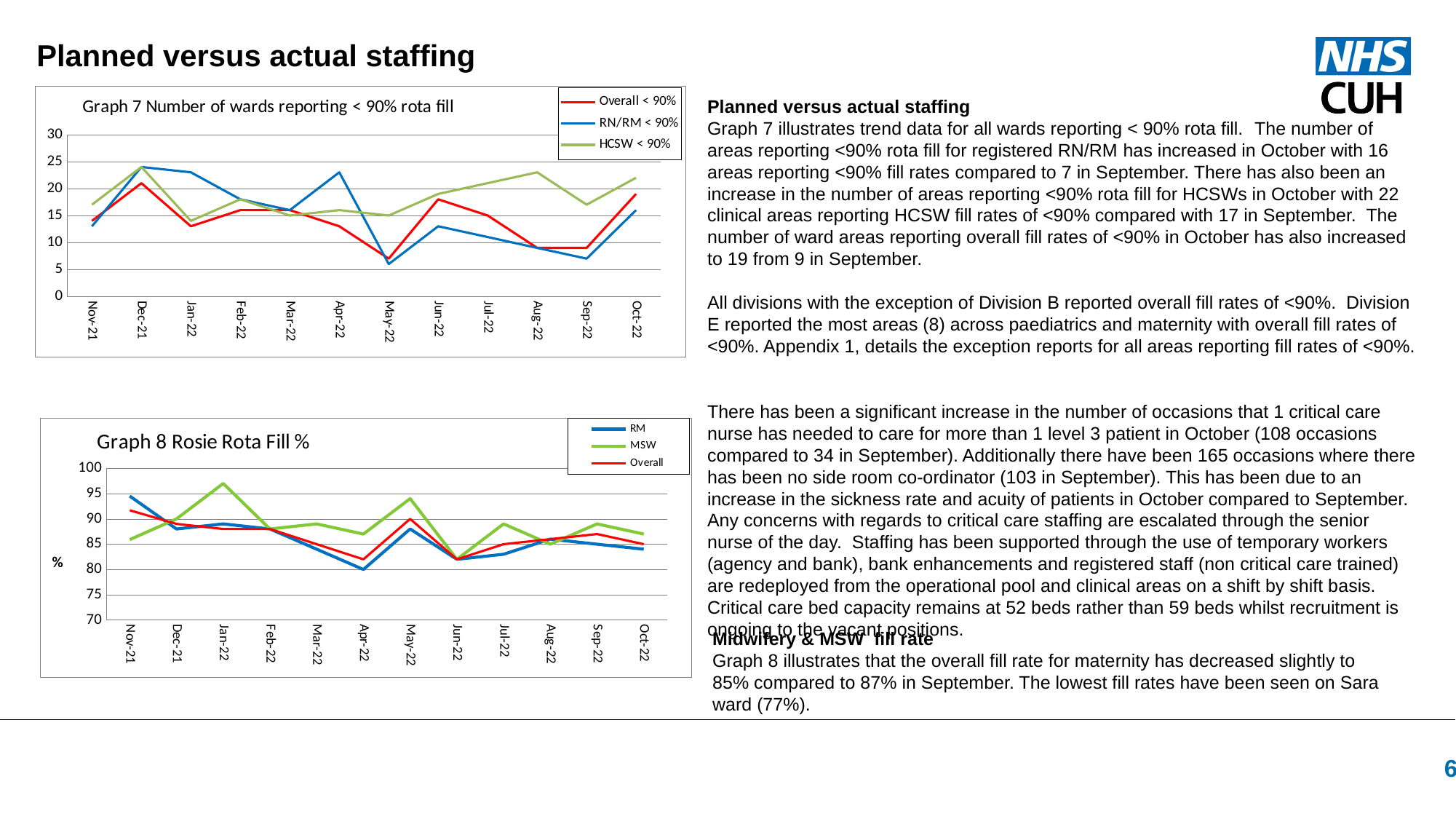
What colour is the Overall line in Graph 8 Rosie Rota Fill %? red In Graph 8 Rosie Rota Fill %, is the MSW value for Jan-22 greater or less than 95? greater In Graph 8 Rosie Rota Fill %, which month has the lowest RM value? Apr-22 In Graph 7 Number of wards reporting < 90% rota fill, which is larger for Apr-22: RN/RM < 90% or Overall < 90%? RN/RM < 90% How many months are shown on the x axis of Graph 8 Rosie Rota Fill %? 12 In Graph 7 Number of wards reporting < 90% rota fill, does the HCSW < 90% line rise or fall from Jun-22 to Aug-22? rise In Graph 7 Number of wards reporting < 90% rota fill, which month has the lowest Overall < 90% value? May-22 In Graph 8 Rosie Rota Fill %, which month has the highest MSW value? Jan-22 How many series does the legend of Graph 7 Number of wards reporting < 90% rota fill list? 3 What type of chart is Graph 7 Number of wards reporting < 90% rota fill? line chart In Graph 7 Number of wards reporting < 90% rota fill, is the Overall < 90% value for May-22 greater or less than 10? less In Graph 7 Number of wards reporting < 90% rota fill, is the RN/RM < 90% value for Apr-22 greater or less than 20? greater